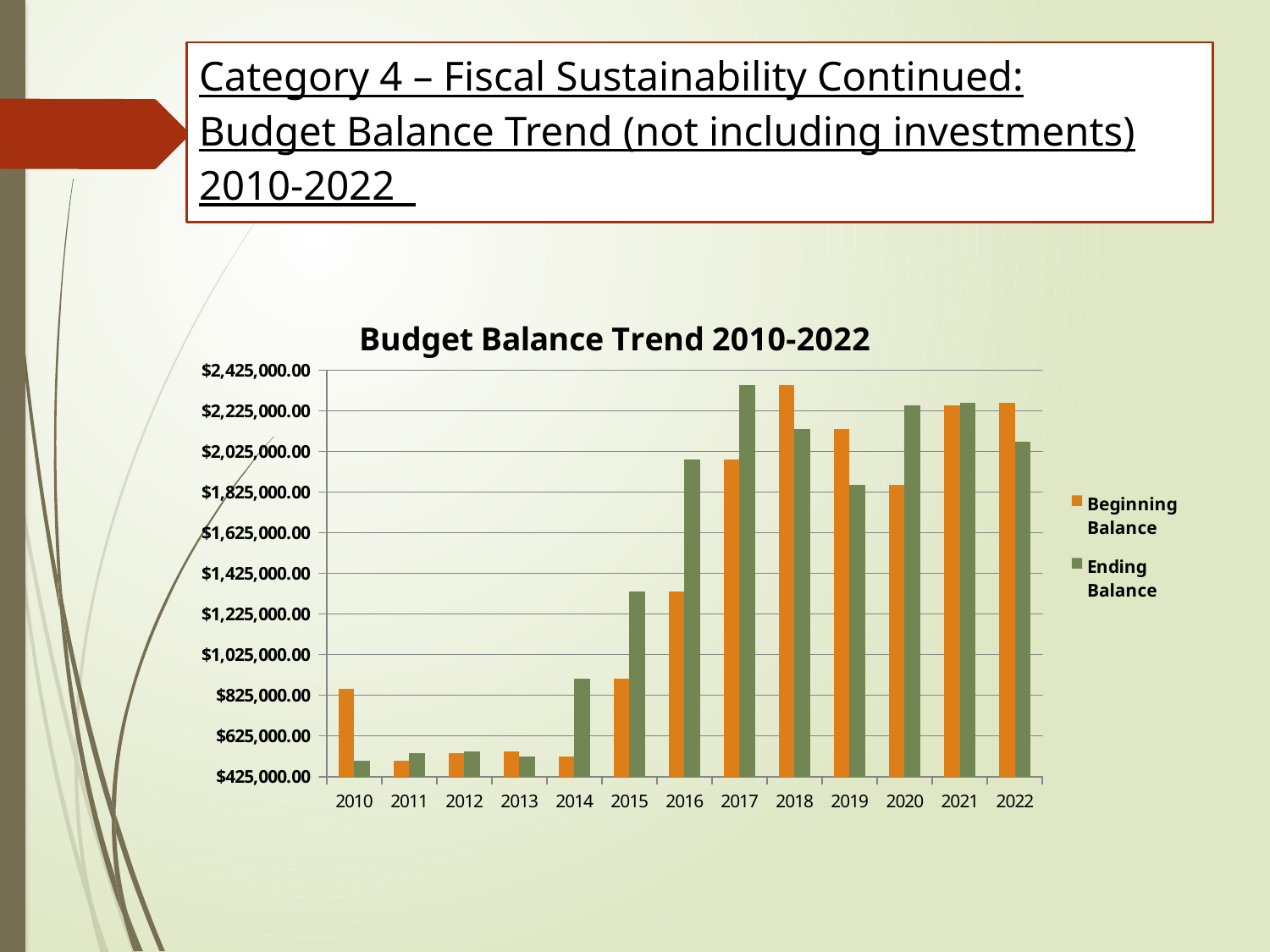
How many series does the legend list? 2 Which year has the highest Beginning Balance? 2018 Is the Ending Balance for 2015 greater or less than $1,425,000.00? less Is the Beginning Balance for 2010 greater or less than $625,000.00? greater Does the Beginning Balance rise or fall from 2014 to 2018? Rise How many years are shown on the x axis of the chart? 13 In 2018, which is larger, the Beginning Balance or the Ending Balance? Beginning Balance What kind of chart is shown on the slide? Bar chart What is the title of the chart? Budget Balance Trend 2010-2022 Which year has the highest Ending Balance? 2017 Is the Ending Balance for 2016 greater or less than $1,825,000.00? greater In 2016, which is larger, the Beginning Balance or the Ending Balance? Ending Balance